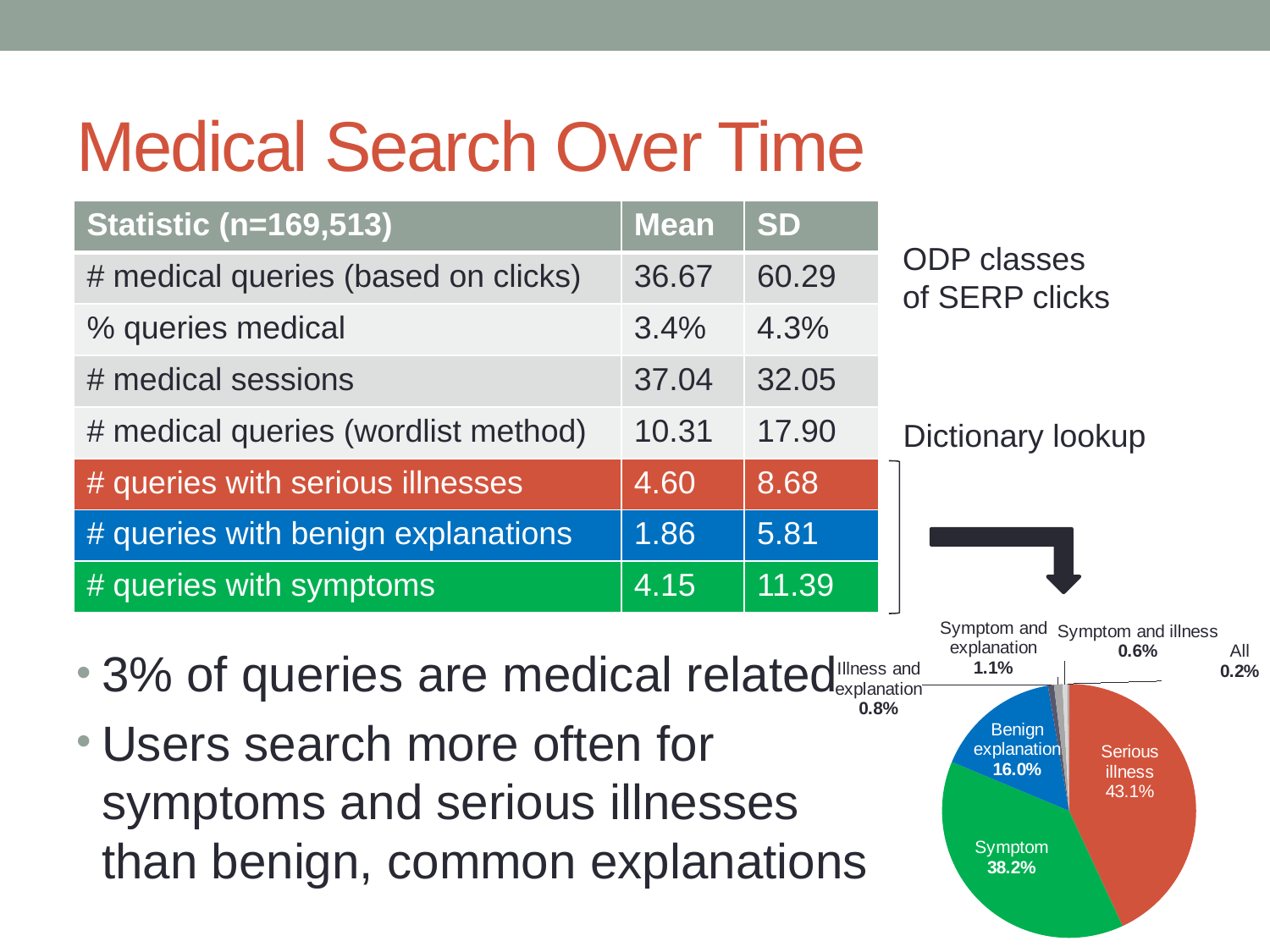
In the pie chart, which is larger: Illness and explanation or Symptom and illness? Illness and explanation In the pie chart, what share is labelled for Symptom? 38.2% In the pie chart, what share is labelled for Benign explanation? 16.0% Which slice of the pie chart is the smallest? All What colour is the Symptom slice in the pie chart? green What kind of chart is shown at the bottom right of the slide? pie chart In the pie chart, what share is labelled for Symptom and explanation? 1.1% Which slice of the pie chart is the largest? Serious illness In the pie chart, what share is labelled for All? 0.2% How many slices does the pie chart have? 7 In the pie chart, what is the difference between the Serious illness share and the Symptom share? 4.9% In the pie chart, what share is labelled for Serious illness? 43.1%